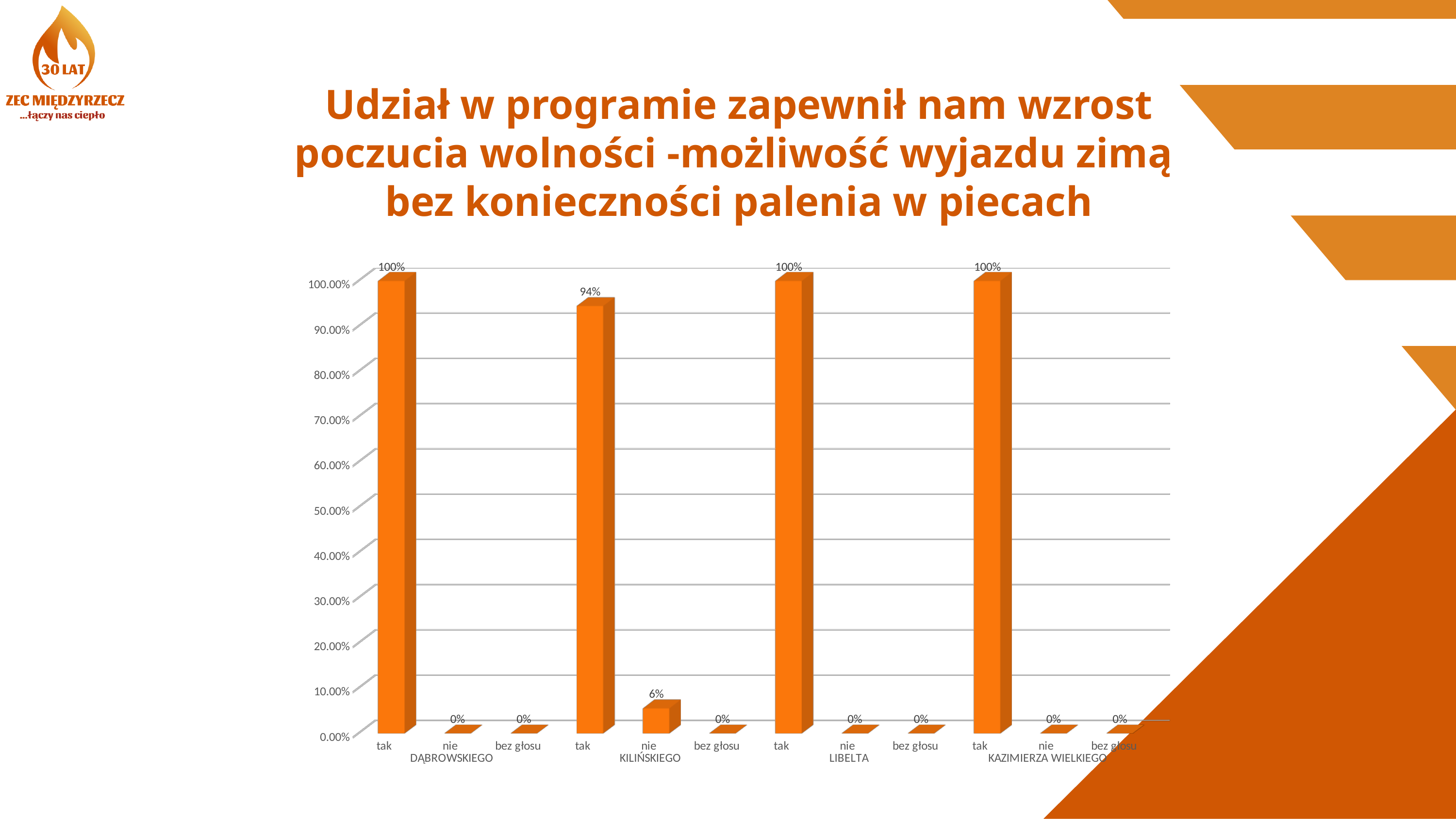
Which group has the lowest value for "tak"? KILIŃSKIEGO What is the value for "nie" in the KILIŃSKIEGO group? 6% What is the value for "tak" in the DĄBROWSKIEGO group? 100% How many street groups are shown on the x axis? 4 What kind of chart is shown on the slide? Bar chart What is the difference between the "tak" and "nie" values in the KILIŃSKIEGO group? 88% What is the value for "tak" in the KILIŃSKIEGO group? 94% What is the highest tick label on the vertical axis? 100.00% Which is larger: "tak" for KILIŃSKIEGO or "tak" for LIBELTA? tak for LIBELTA What is the value for "nie" in the KAZIMIERZA WIELKIEGO group? 0% What is the value for "bez głosu" in the LIBELTA group? 0% How many bars are plotted in the chart? 12